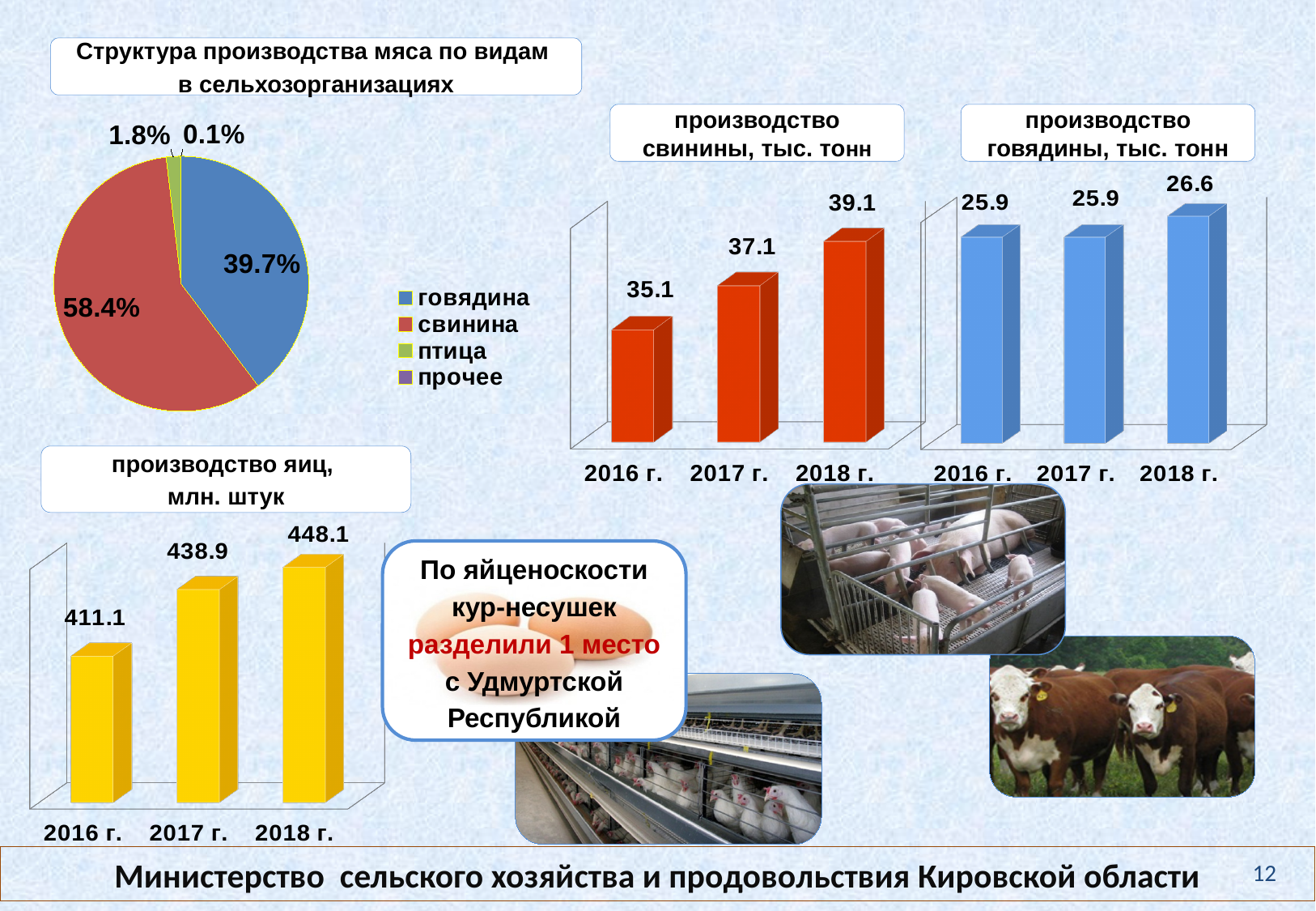
In the chart 'производство свинины, тыс. тонн', what is the value for 2018 г.? 39.1 In the chart 'производство свинины, тыс. тонн', what is the difference between 2018 г. and 2016 г.? 4.0 In the chart 'производство говядины, тыс. тонн', which year has the highest value? 2018 г. In the pie chart 'Структура производства мяса по видам в сельхозорганизациях', what share does говядина have? 39.7% How many categories does the legend of the pie chart 'Структура производства мяса по видам в сельхозорганизациях' list? 4 In the pie chart 'Структура производства мяса по видам в сельхозорганизациях', which category has the smallest share? прочее In the chart 'производство яиц, млн. штук', what is the value for 2016 г.? 411.1 In the chart 'производство говядины, тыс. тонн', what is the value for 2017 г.? 25.9 In the chart 'производство свинины, тыс. тонн', do the values rise or fall from 2016 г. to 2018 г.? rise What type of chart is 'производство яиц, млн. штук'? bar chart In the chart 'производство яиц, млн. штук', which is larger: the value for 2017 г. or 2018 г.? 2018 г. In the pie chart 'Структура производства мяса по видам в сельхозорганизациях', what share does свинина have? 58.4%